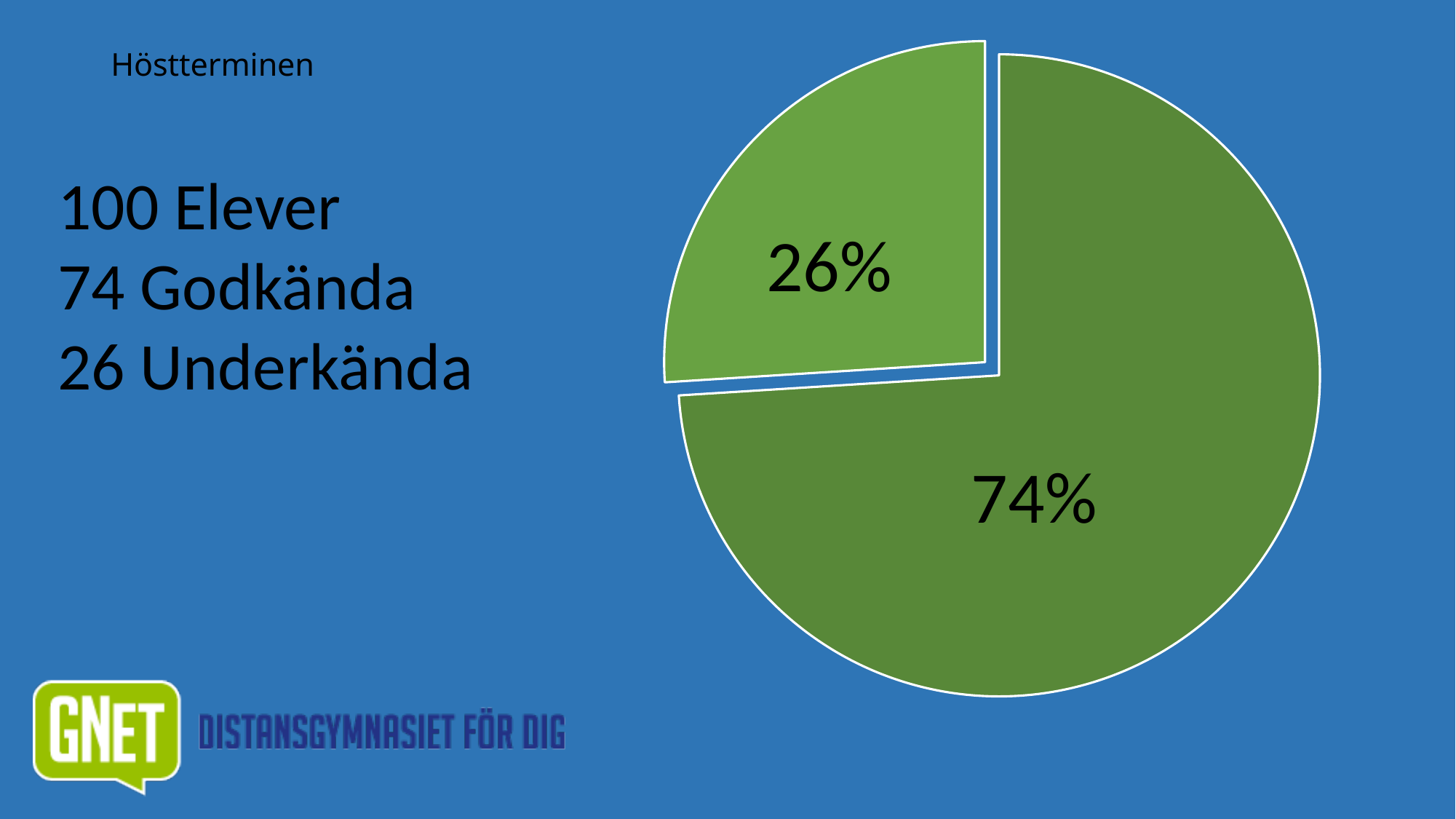
What do the two slice percentages in the pie chart add up to? 100% Which slice of the pie chart is drawn in the lighter green colour, the 74% slice or the 26% slice? 26% What kind of chart is shown on the slide? pie chart What percentage is shown on the smallest slice of the pie chart? 26% According to the slide text, what share of the pie corresponds to Godkända? 74% What is the difference in percentage points between the two slices of the pie chart? 48 What share of the pie does the larger slice represent? 74% What percentage is shown on the largest slice of the pie chart? 74% Which slice of the pie chart is larger, the one labelled 74% or the one labelled 26%? 74% Is the larger slice of the pie chart greater or less than 50%? greater According to the slide text, what share of the pie corresponds to Underkända? 26% How many slices does the pie chart have? 2